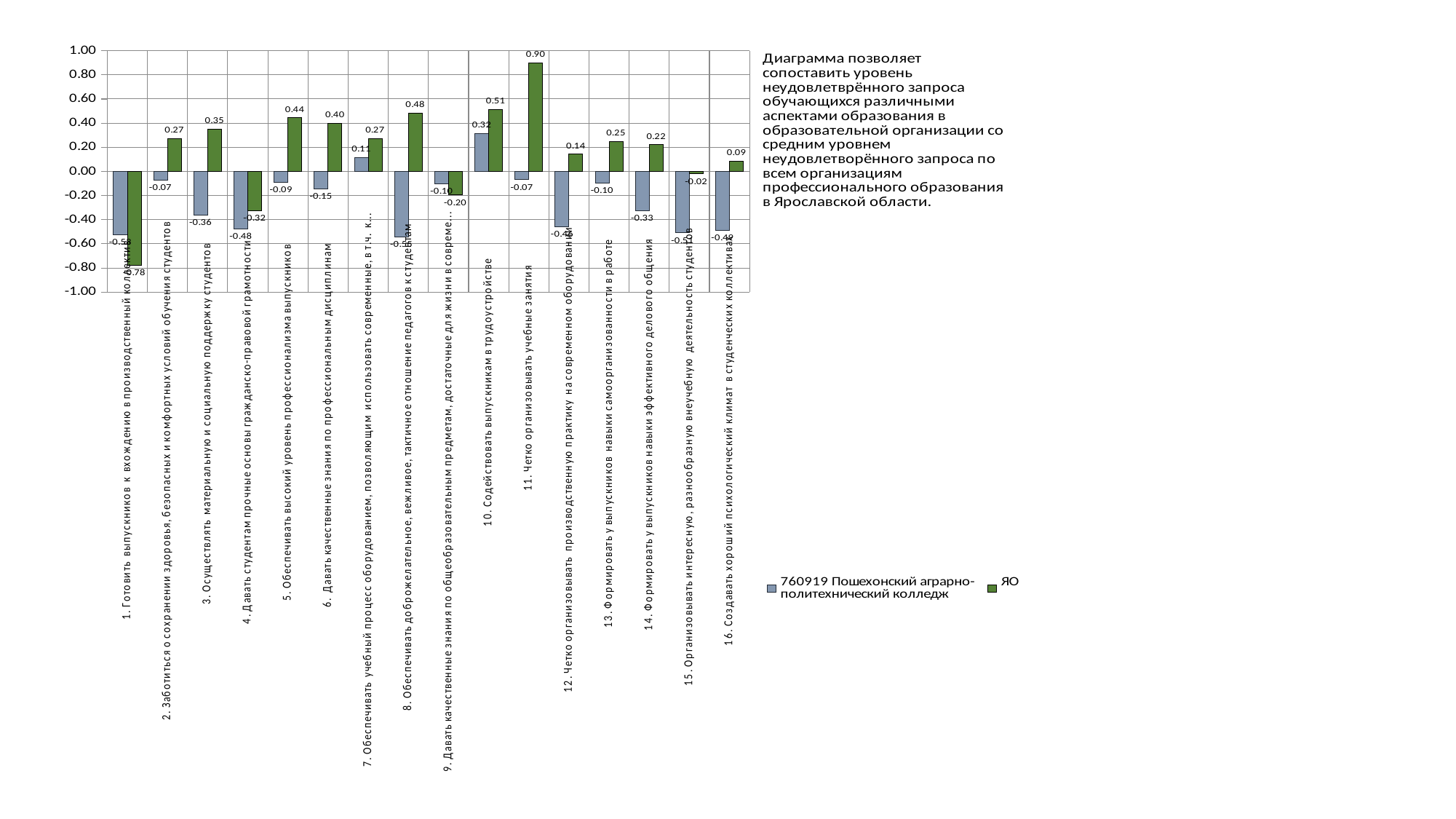
What kind of chart is shown on the slide? bar chart What is the ЯО value for category 11 (Четко организовывать учебные занятия)? 0.90 What is the value for 760919 Пошехонский аграрно-политехнический колледж for category 14 (Формировать у выпускников навыки эффективного делового общения)? -0.33 Which category has the lowest ЯО value? 1. Готовить выпускников к вхождению в производственный коллектив For category 10, what is the difference between the ЯО value and the 760919 Пошехонский аграрно-политехнический колледж value? 0.19 Is the ЯО value for category 11 greater or less than 0.80? greater For category 4, which series has the larger value: 760919 Пошехонский аграрно-политехнический колледж or ЯО? ЯО How many categories are plotted along the x axis? 16 Which category has the highest ЯО value? 11. Четко организовывать учебные занятия How many series does the legend list? 2 What is the value for 760919 Пошехонский аграрно-политехнический колледж for category 10 (Содействовать выпускникам в трудоустройстве)? 0.32 What is the ЯО value for category 5 (Обеспечивать высокий уровень профессионализма выпускников)? 0.44